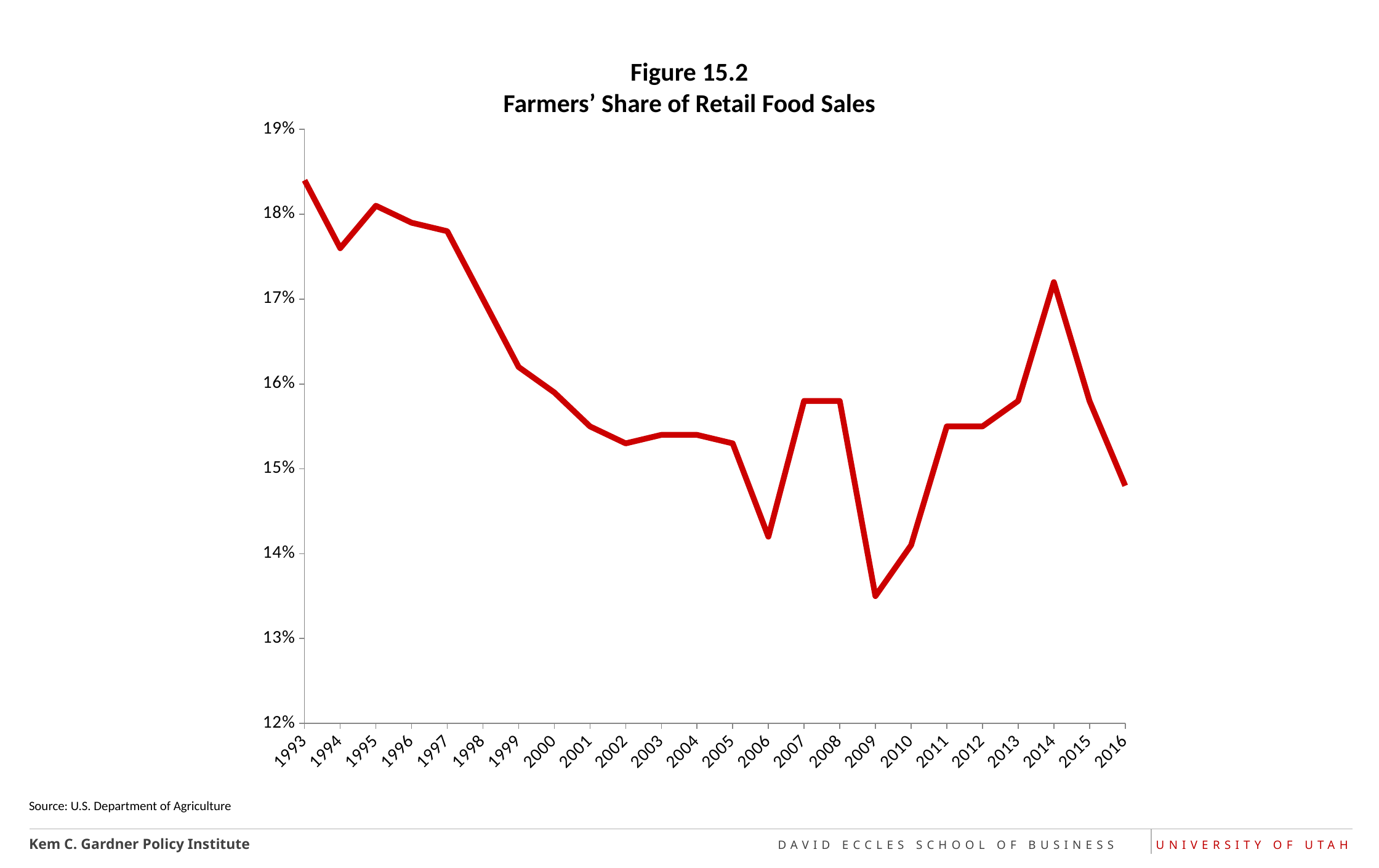
Is the value for 2014 greater or less than 17%? greater Is the value for 1993 greater or less than 18%? greater Is the value for 2009 greater or less than 14%? less Which year has the highest farmers' share of retail food sales? 1993 What kind of chart is shown on the slide? Line chart Which year has the larger value, 2006 or 2007? 2007 What is the source cited for the chart? U.S. Department of Agriculture Overall, does the farmers' share of retail food sales rise or fall from 1993 to 2016? Fall How many years are plotted along the x axis? 24 Which year has the lowest farmers' share of retail food sales? 2009 Which year has the larger value, 2014 or 2016? 2014